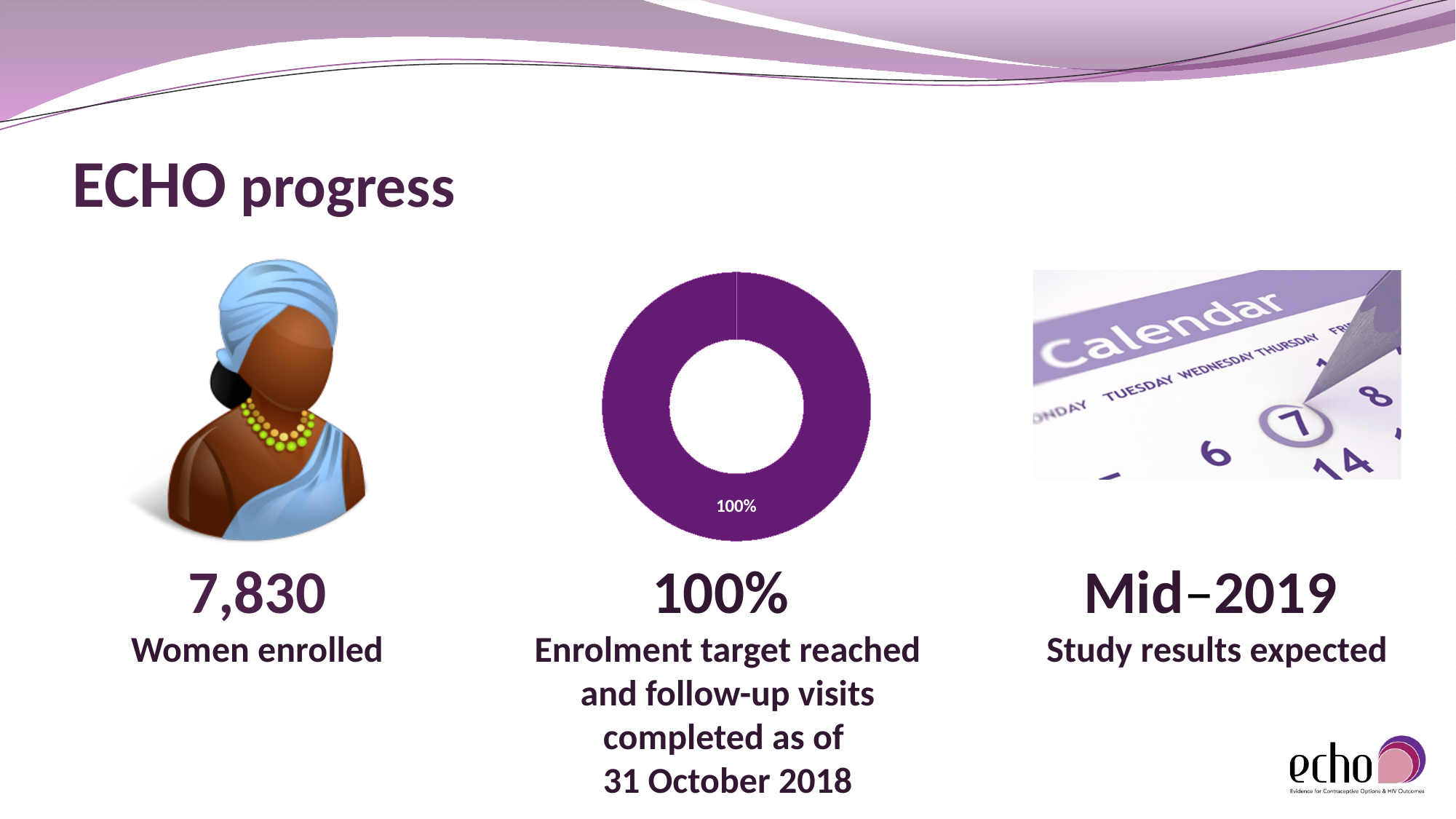
What kind of chart is shown in the middle of the slide? Donut chart How many data segments does the donut chart contain? 1 What colour is the filled segment of the donut chart? Purple What value is printed on the donut chart? 100% What does the 100% shown on the donut chart represent, according to the caption below it? Enrolment target reached and follow-up visits completed as of 31 October 2018 What share of the donut chart does the single filled segment represent? 100%